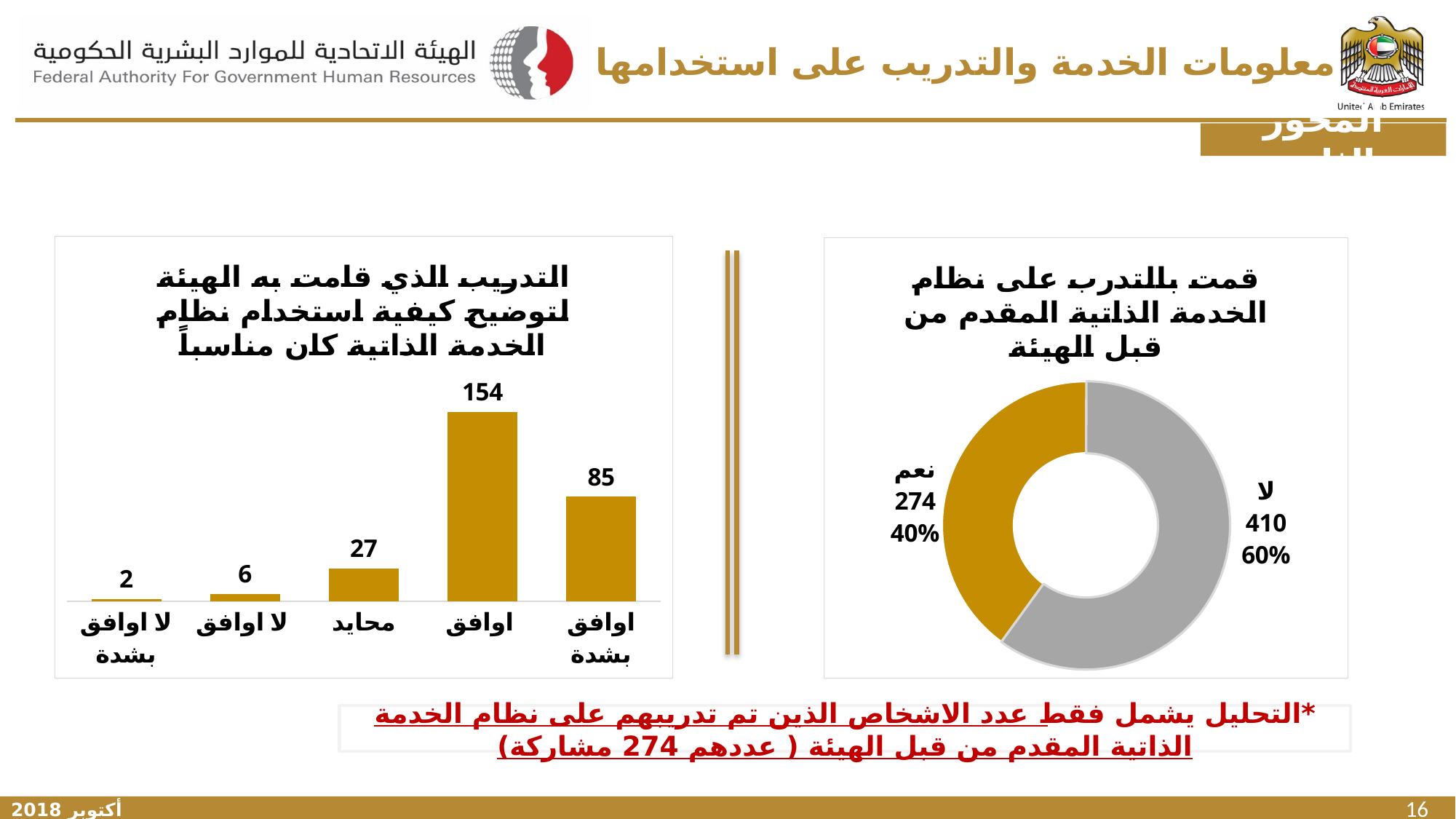
In the donut chart on the right, which slice is larger: "نعم" or "لا"? لا In the donut chart on the right, what is the value for "لا"? 410 In the bar chart on the left, which category has the lowest value? لا اوافق بشدة In the bar chart on the left, which is larger: the value for "لا اوافق" or the value for "محايد"? محايد In the bar chart on the left, which category has the highest value? اوافق In the bar chart on the left, what is the value for "محايد"? 27 What type of chart is shown on the right side of the slide? Donut chart In the donut chart on the right, what share does "نعم" represent? 40% In the bar chart on the left, what is the difference between the values for "اوافق" and "اوافق بشدة"? 69 What type of chart is shown on the left side of the slide? Bar chart In the bar chart on the left, what is the value for "اوافق"? 154 How many categories are shown in the bar chart on the left? 5